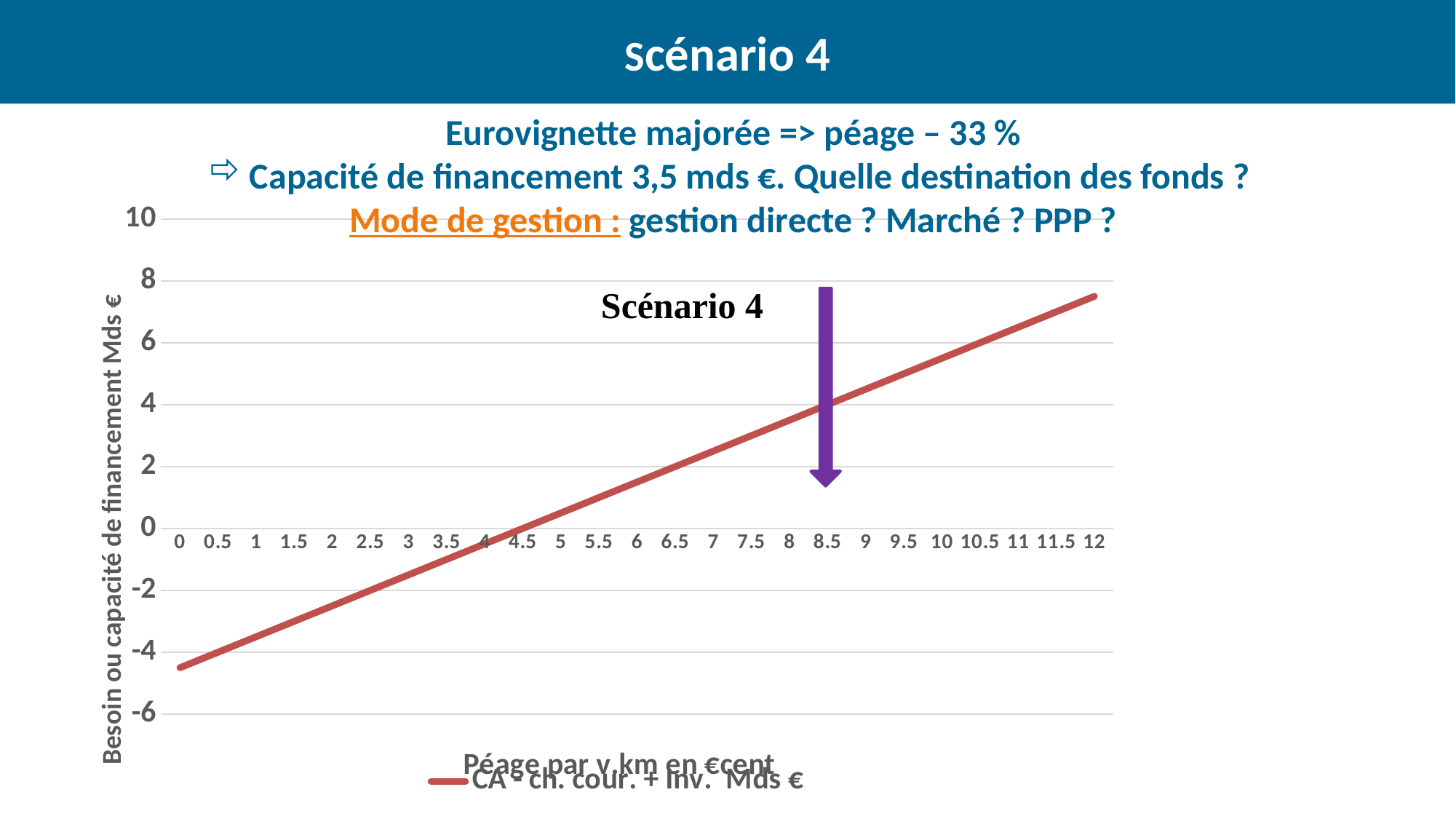
Is the value of the line at x = 8.5 greater or less than 2? greater Is the value of the line at x = 2 greater or less than 0? less Does the plotted line rise or fall as the toll per v.km increases along the x axis? rise Is the value of the line at x = 0 greater or less than -4? less What is the legend entry for the plotted series? CA - ch. cour. + Inv. Mds € How many tick labels are shown along the x axis? 25 What kind of chart is shown on the slide? line chart How many series does the legend list? 1 Which x value has the higher plotted value, 0 or 12? 12 What is the title of the vertical axis? Besoin ou capacité de financement Mds €